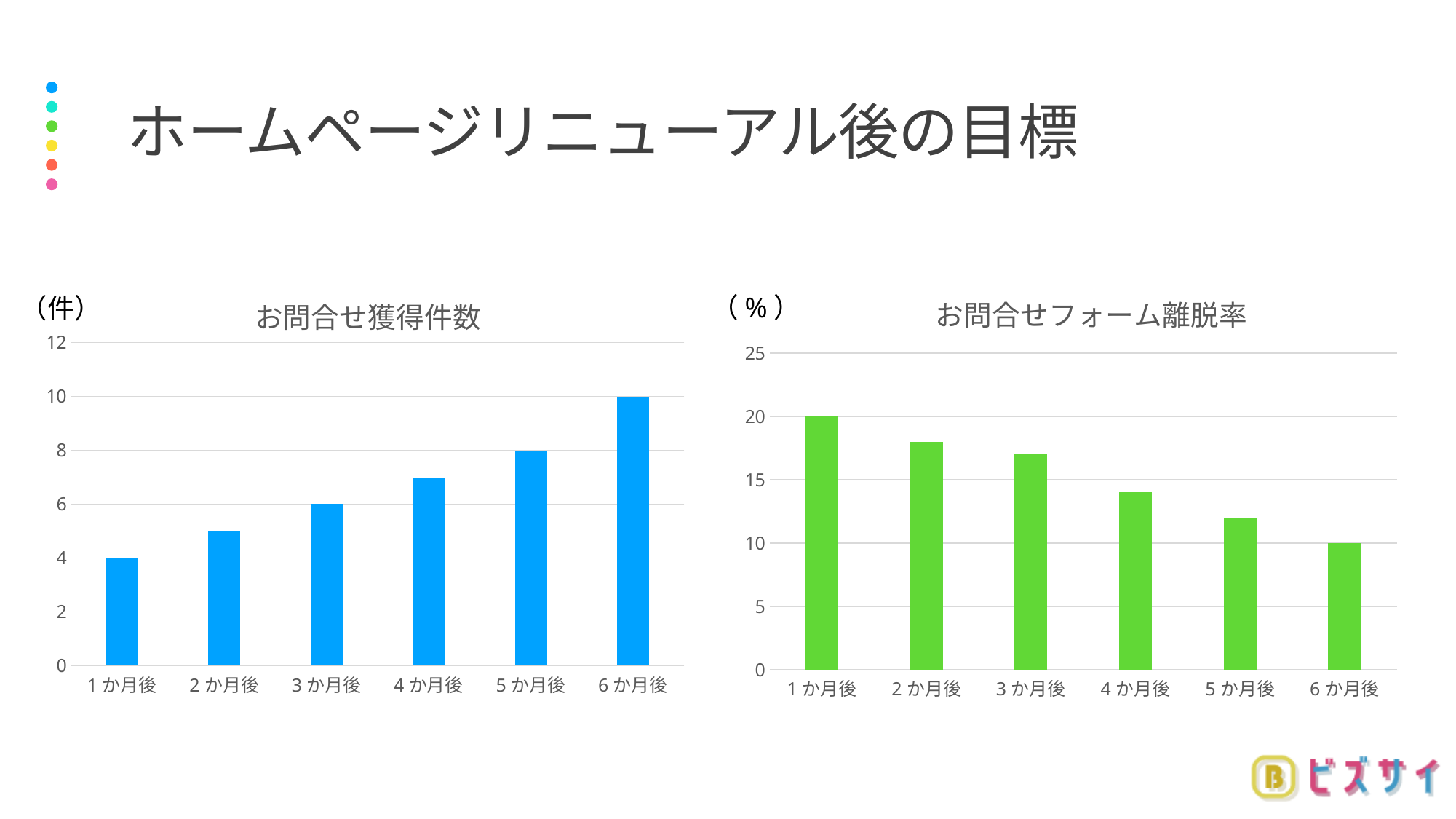
What type of chart is the left chart titled お問合せ獲得件数? bar chart In the left chart (お問合せ獲得件数), what is the value for 6か月後? 10 In the left chart (お問合せ獲得件数), what is the difference between the values for 6か月後 and 1か月後? 6 In the left chart (お問合せ獲得件数), which month has the highest value? 6か月後 In the left chart (お問合せ獲得件数), do the values rise or fall from 1か月後 to 6か月後? rise In the right chart (お問合せフォーム離脱率), what is the value for 1か月後? 20 In the right chart (お問合せフォーム離脱率), which month has the lowest value? 6か月後 In the right chart (お問合せフォーム離脱率), is the value for 3か月後 greater or less than 15? greater In the right chart (お問合せフォーム離脱率), what is the difference between the values for 1か月後 and 6か月後? 10 In the right chart (お問合せフォーム離脱率), how many months are shown on the x axis? 6 In the left chart (お問合せ獲得件数), what is the value for 1か月後? 4 In the left chart (お問合せ獲得件数), is the value for 2か月後 greater or less than 4? greater